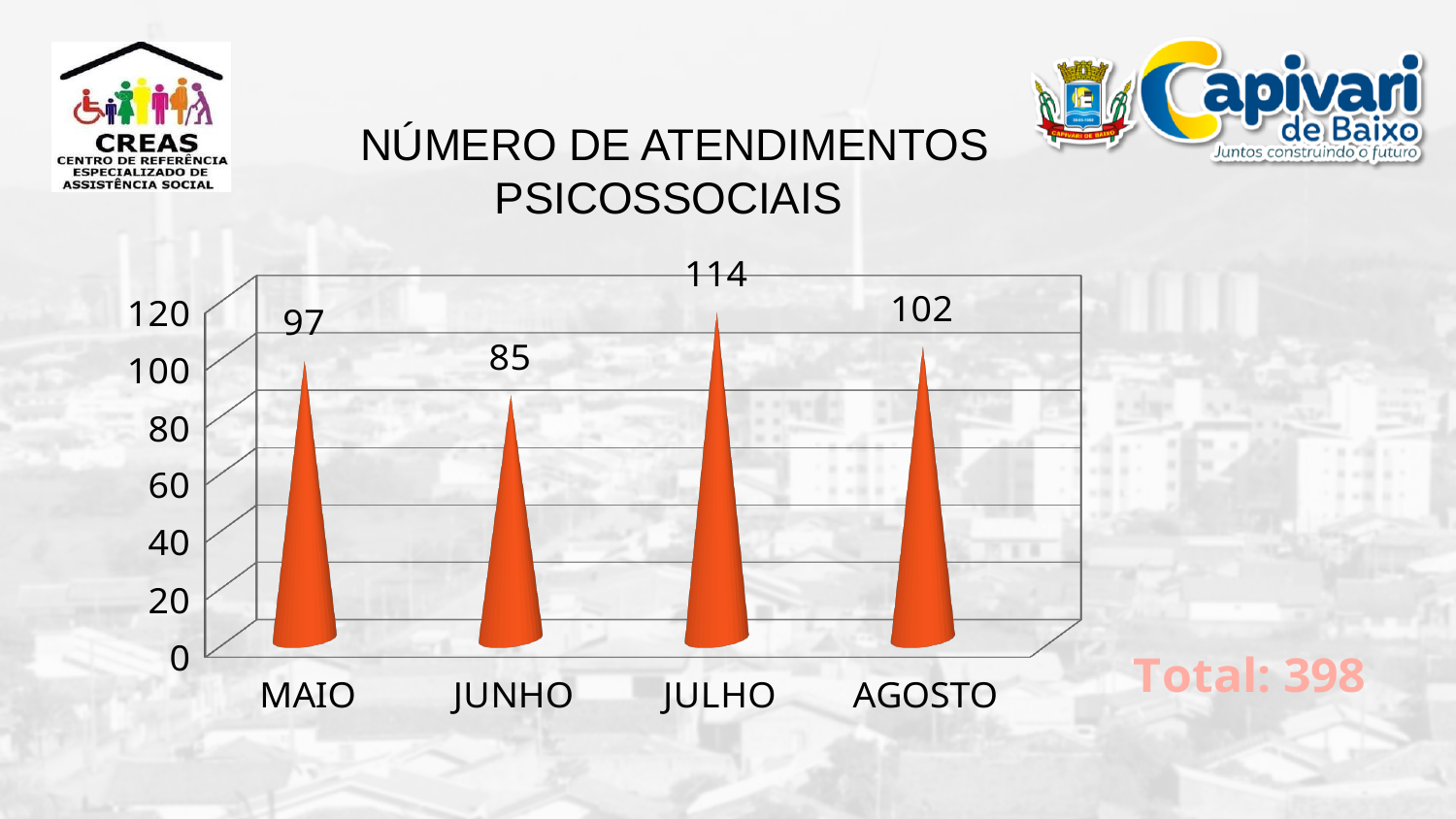
What kind of chart is shown on the slide? bar chart What is the value for JUNHO? 85 What is the title of the chart? NÚMERO DE ATENDIMENTOS PSICOSSOCIAIS What is the value for MAIO? 97 What is the value for AGOSTO? 102 What is the difference between the values for AGOSTO and MAIO? 5 Which month has the lowest number of atendimentos? JUNHO What is the difference between the values for JULHO and JUNHO? 29 What is the value for JULHO? 114 Which month has the highest number of atendimentos? JULHO How many months are shown on the x axis? 4 Which is larger, the value for MAIO or the value for AGOSTO? AGOSTO